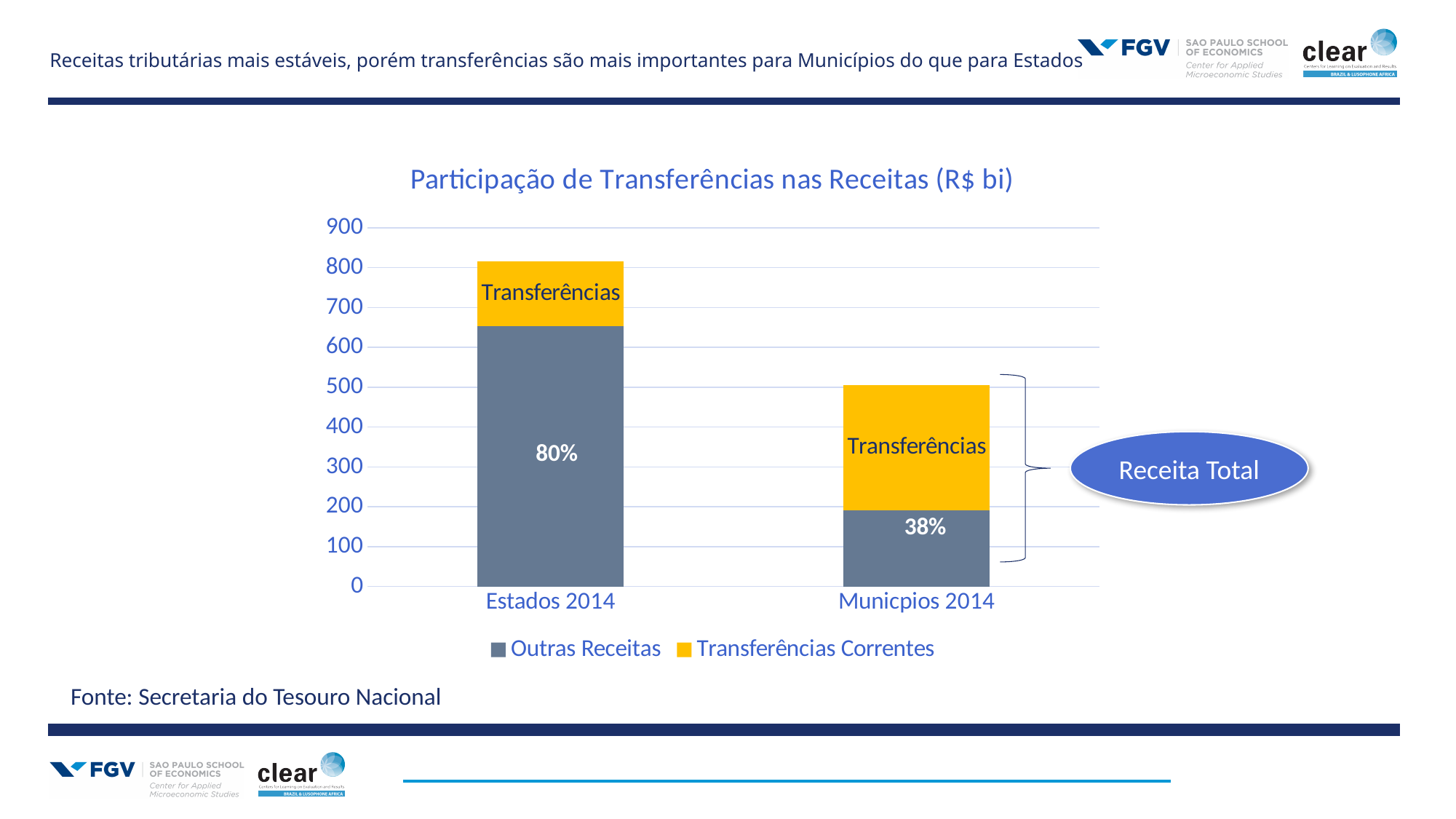
Is the Outras Receitas value for Municpios 2014 greater or less than 300? less How many series does the legend list? 2 Is the Outras Receitas value for Estados 2014 greater or less than 600? greater Which series is shown in yellow in the legend? Transferências Correntes Which category has the taller total bar, Estados 2014 or Municpios 2014? Estados 2014 Is the total of the Estados 2014 bar greater or less than 700? greater What percentage label is printed on the Outras Receitas segment of the Municpios 2014 bar? 38% What kind of chart is shown on the slide? Stacked bar chart What percentage label is printed on the Outras Receitas segment of the Estados 2014 bar? 80% What is the title of the chart? Participação de Transferências nas Receitas (R$ bi) How many categories are shown on the x axis? 2